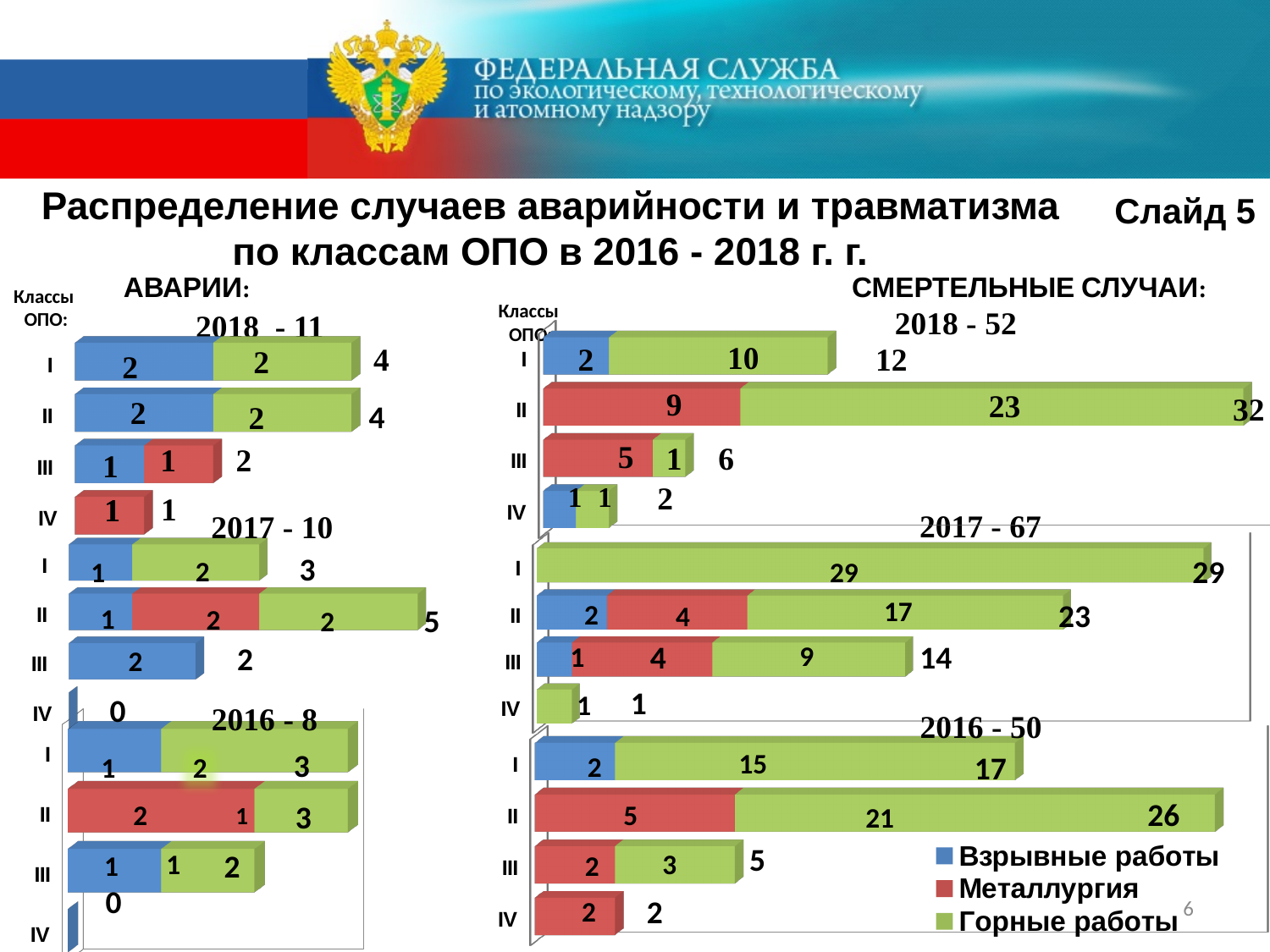
In the СМЕРТЕЛЬНЫЕ СЛУЧАИ 2017 chart, which class has the highest total? I In the СМЕРТЕЛЬНЫЕ СЛУЧАИ 2017 chart, what is the total of the stacked bar for class III? 14 In the АВАРИИ 2017 chart, which class has the larger total, class I or class II? II In the СМЕРТЕЛЬНЫЕ СЛУЧАИ 2018 chart, what is the difference between the totals for class II and class I? 20 In the СМЕРТЕЛЬНЫЕ СЛУЧАИ 2016 chart, which class has the lowest total? IV Which series is shown in green in the legend? Горные работы How many classes are shown in the АВАРИИ 2016 chart? 4 In the СМЕРТЕЛЬНЫЕ СЛУЧАИ 2018 chart, what is the Горные работы value for class II? 23 How many series does the legend list? 3 In the СМЕРТЕЛЬНЫЕ СЛУЧАИ 2016 chart, what is the Металлургия value for class II? 5 What kind of chart is used for the СМЕРТЕЛЬНЫЕ СЛУЧАИ 2017 data? Stacked bar chart In the АВАРИИ 2018 chart, what is the total value for class II? 4